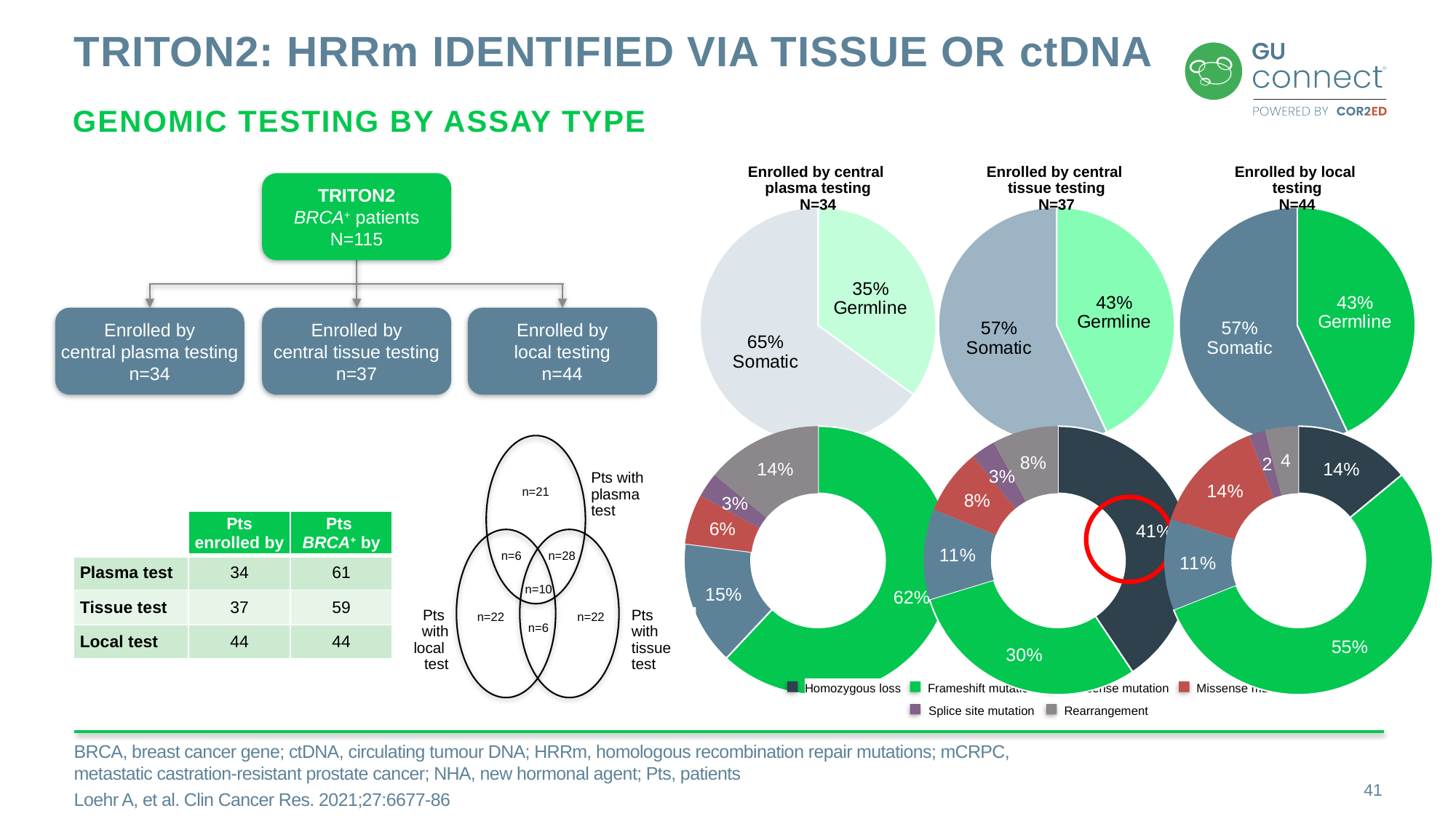
In the pie chart 'Enrolled by central plasma testing N=34', what percentage of patients are Somatic? 65% In the donut chart below 'Enrolled by central plasma testing N=34', what is the largest segment's percentage? 62% What type of chart is used for 'Enrolled by central plasma testing N=34'? Pie chart In the pie chart 'Enrolled by central plasma testing N=34', what percentage of patients are Germline? 35% In the pie chart 'Enrolled by central tissue testing N=37', what percentage of patients are Germline? 43% How many mutation types does the legend below the donut charts list? 6 In the donut chart below 'Enrolled by local testing N=44', what is the percentage for Homozygous loss (the dark segment)? 14% In the donut chart below 'Enrolled by central tissue testing N=37', what is the percentage for Homozygous loss (the dark segment circled in red)? 41% In the pie chart 'Enrolled by central plasma testing N=34', what is the difference in percentage points between the Somatic and Germline slices? 30 percentage points In the donut chart below 'Enrolled by local testing N=44', what is the largest segment's percentage? 55% In the donut chart below 'Enrolled by central plasma testing N=34', what is the percentage for Rearrangement (the grey segment)? 14% In the pie chart 'Enrolled by local testing N=44', what percentage of patients are Somatic? 57%